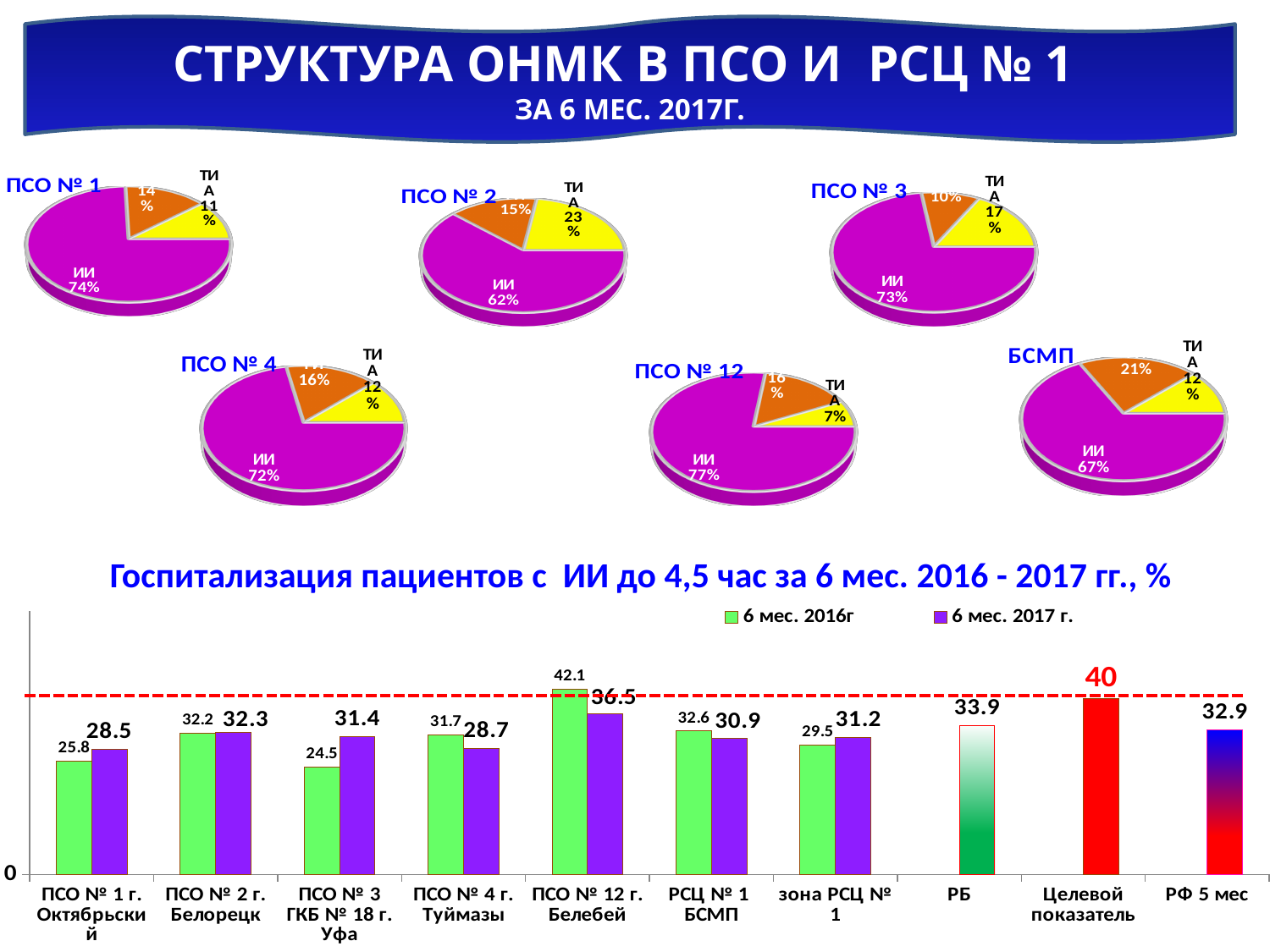
In the bar chart 'Госпитализация пациентов с ИИ до 4,5 час', what is the value for ПСО № 12 г. Белебей for 6 мес. 2016г? 42.1 In the БСМП pie chart, which slice is the largest? ИИ In the ПСО № 1 pie chart, what share is labelled ИИ? 74% In the bar chart 'Госпитализация пациентов с ИИ до 4,5 час', what is the value for ПСО № 3 ГКБ № 18 г. Уфа for 6 мес. 2017 г.? 31.4 In the bar chart 'Госпитализация пациентов с ИИ до 4,5 час', what is the difference between the 6 мес. 2016г and 6 мес. 2017 г. values for ПСО № 1 г. Октябрьский? 2.7 In the ПСО № 12 pie chart, what share is labelled ТИА? 7% In the ПСО № 2 pie chart, what share is labelled ТИА? 23% Which pie chart shows the highest ИИ share: ПСО № 2 or ПСО № 12? ПСО № 12 In the bar chart 'Госпитализация пациентов с ИИ до 4,5 час', what is the value for Целевой показатель? 40 In the bar chart 'Госпитализация пациентов с ИИ до 4,5 час', which is larger for ПСО № 4 г. Туймазы: the 6 мес. 2016г value or the 6 мес. 2017 г. value? 6 мес. 2016г In the bar chart 'Госпитализация пациентов с ИИ до 4,5 час', how many series does the legend list? 2 What type of chart is the 'Госпитализация пациентов с ИИ до 4,5 час' chart at the bottom of the slide? Bar chart